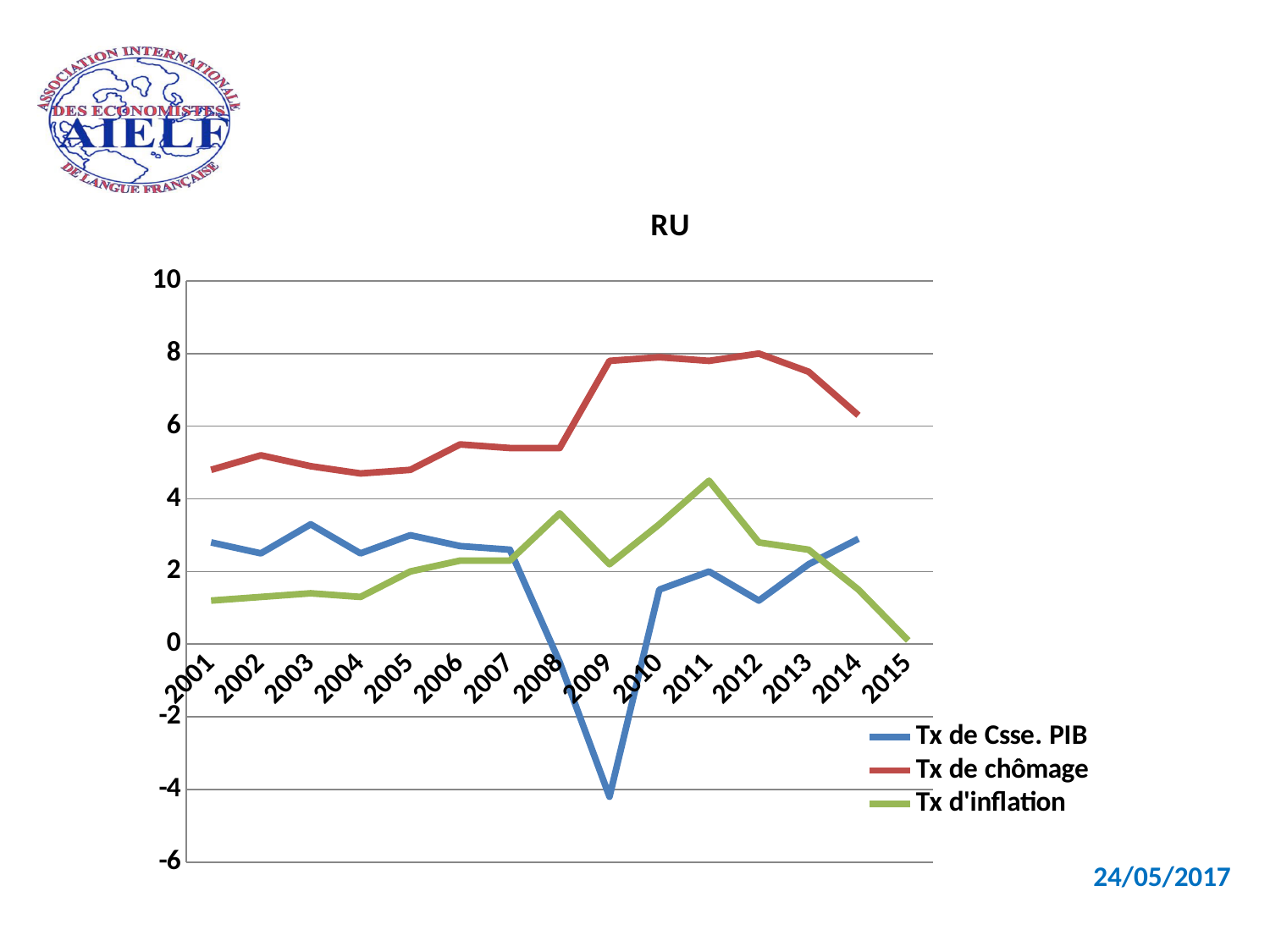
How many years are shown on the x axis? 15 What kind of chart is shown on the slide? line chart In which year is Tx d'inflation at its highest? 2011 In 2011, which is larger: Tx d'inflation or Tx de Csse. PIB? Tx d'inflation Is the value of Tx d'inflation in 2015 greater or less than 2? less In 2009, which is larger: Tx de chômage or Tx d'inflation? Tx de chômage Is the value of Tx de chômage in 2009 greater or less than 6? greater Is the value of Tx de Csse. PIB in 2009 greater or less than -2? less In which year is Tx de Csse. PIB at its lowest? 2009 How many series does the legend list? 3 Does Tx de chômage rise or fall from 2012 to 2014? fall What is the title of the chart? RU